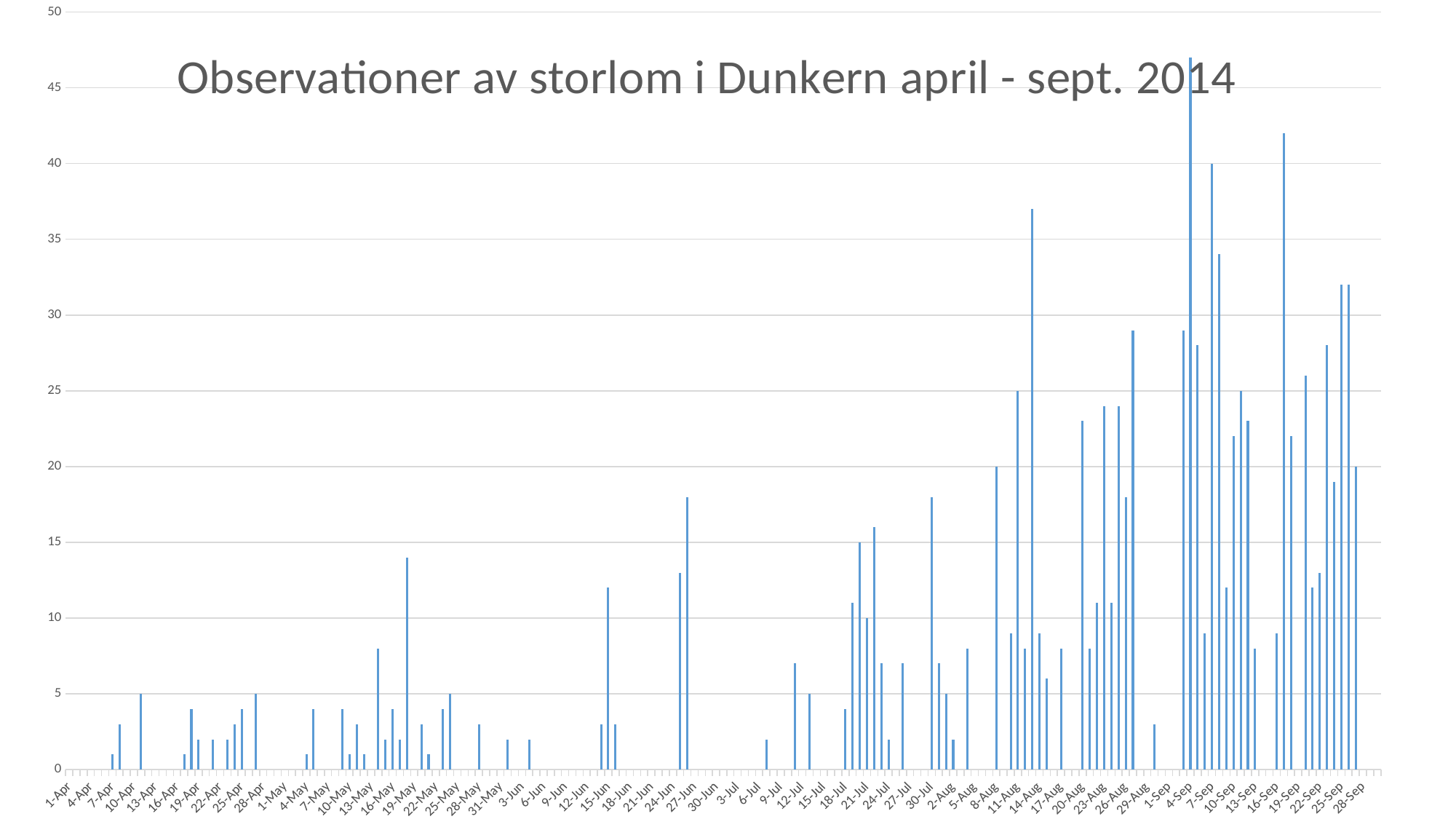
Is the tallest bar in August greater or less than 25? greater Is the tallest bar in May greater or less than 15? less Do the observation counts generally rise or fall from April to September? rise What is the highest value shown on the vertical axis? 50 Is the tallest bar in June greater or less than 20? less What kind of chart is shown on the slide? bar chart In which month does the tallest bar of the chart occur? September What is the title of the chart? Observationer av storlom i Dunkern april - sept. 2014 Which month has the taller maximum bar, April or September? September